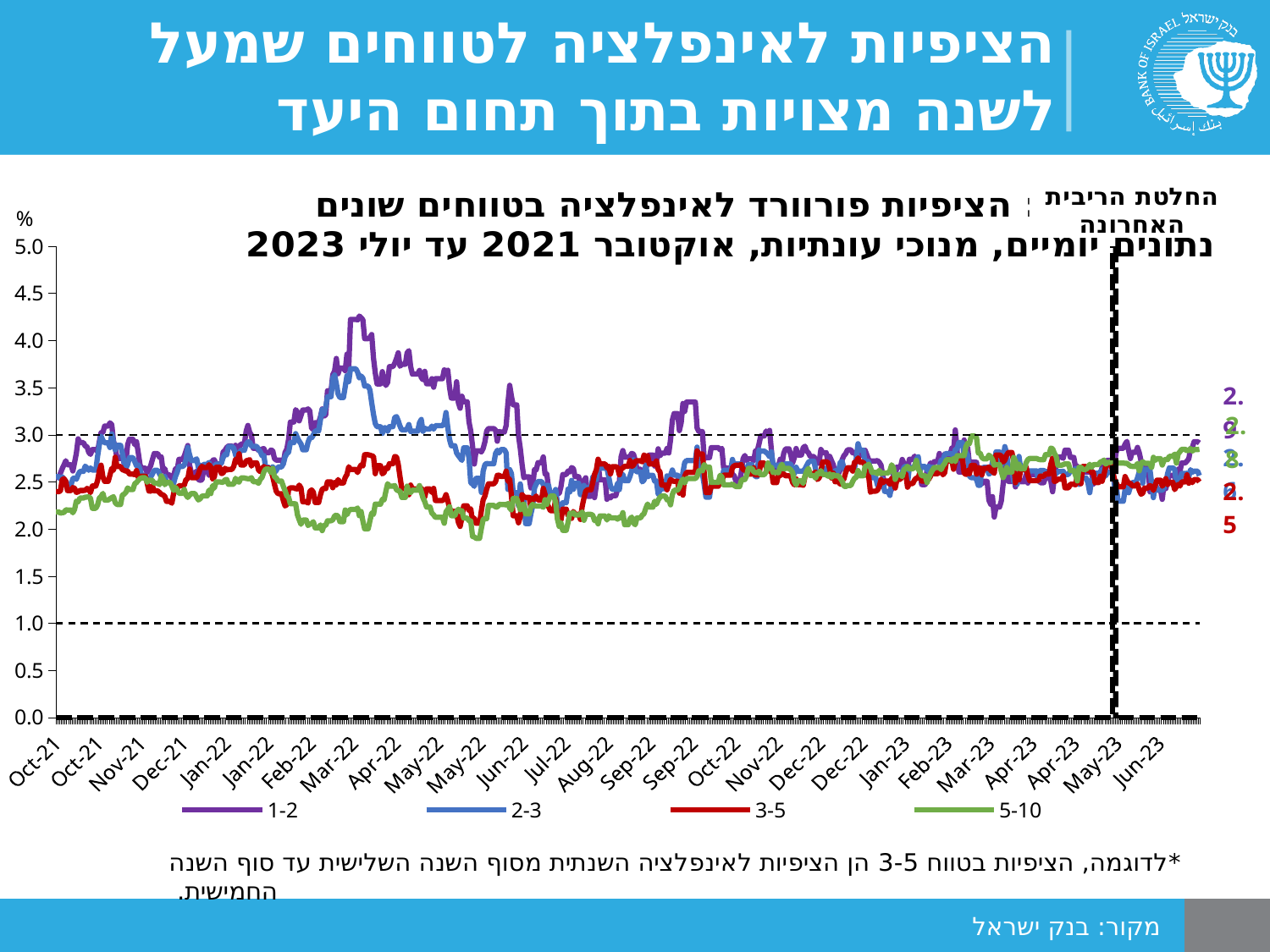
What kind of chart is shown on the slide? line chart Is the value of the 5-10 series around Feb-22 greater or less than 2.5? less Does the 1-2 series rise or fall between Mar-22 and Jul-22? fall Which series reaches the highest value on the chart? 1-2 Around Mar-22, which series is higher: 1-2 or 3-5? 1-2 At which values are the two horizontal dashed lines drawn? 1.0 and 3.0 What are the series names listed in the legend? 1-2, 2-3, 3-5, 5-10 Around Feb-22, which series is lower: 5-10 or 3-5? 5-10 Is the value of the 3-5 series around Jun-23 greater or less than 3.0? less Is the value of the 2-3 series around Mar-22 greater or less than 3.0? greater How many series does the legend list? 4